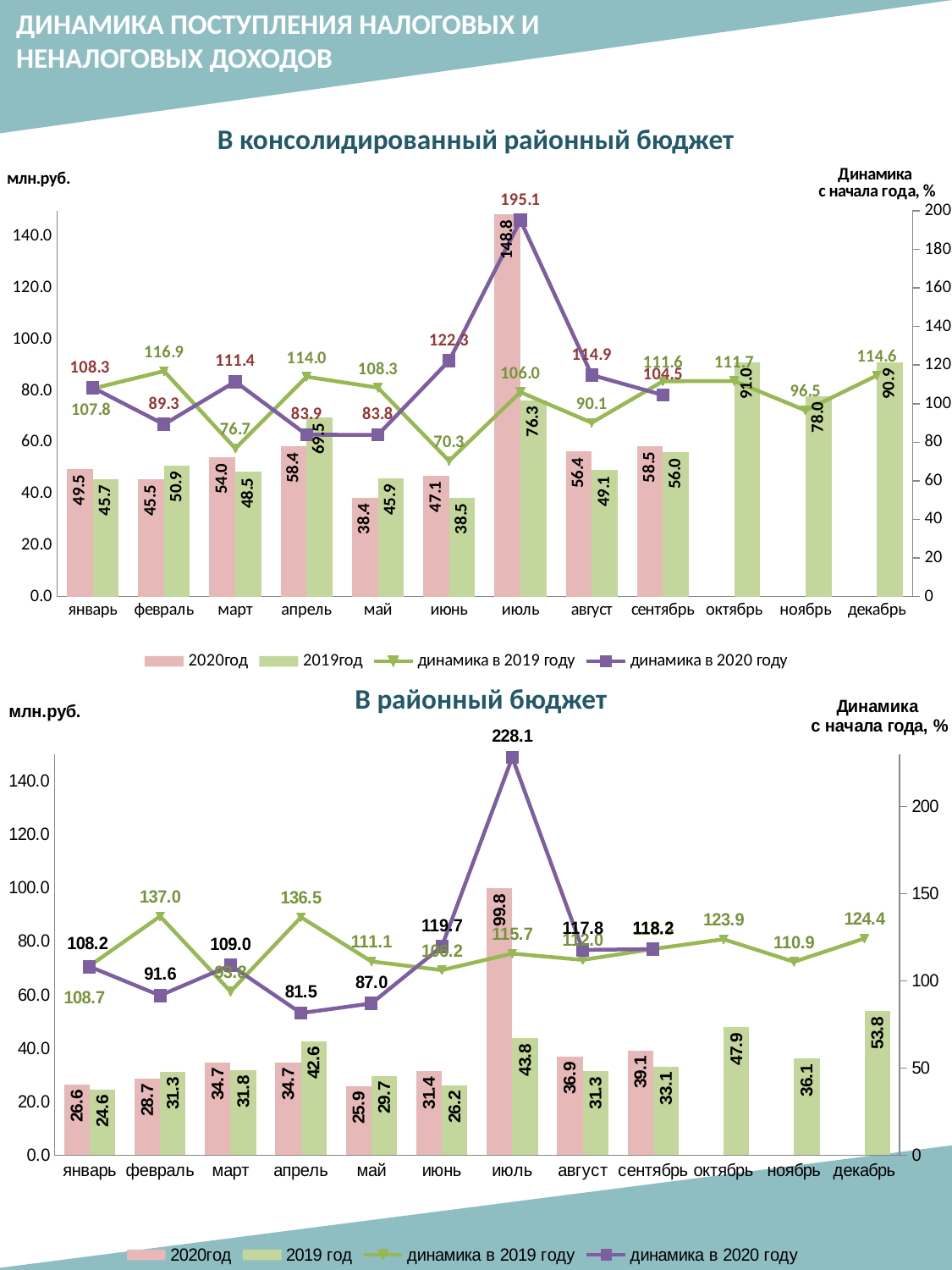
In the chart 'В консолидированный районный бюджет', what is the value of 'динамика в 2020 году' for июль? 195.1 In the chart 'В консолидированный районный бюджет', what is the value of the 2020год bar for июль? 148.8 In the chart 'В консолидированный районный бюджет', which month has the highest 2020год bar? июль In the chart 'В районный бюджет', how many months are shown on the x axis? 12 In the chart 'В консолидированный районный бюджет', which month has the lowest 2019год bar? июнь In the chart 'В районный бюджет', what is the value of 'динамика в 2020 году' for июль? 228.1 In the chart 'В районный бюджет', which is larger for май: the 2020год bar or the 2019год bar? 2019год In the chart 'В районный бюджет', what is the difference between the 2019год bars for декабрь and ноябрь? 17.7 In the chart 'В консолидированный районный бюджет', what is the difference between the 2020год and 2019год bars for апрель? 11.1 In the chart 'В консолидированный районный бюджет', what is the value of the 2019год bar for октябрь? 91.0 In the chart 'В районный бюджет', what is the value of the 2020год bar for июль? 99.8 In the chart 'В консолидированный районный бюджет', how many series does the legend list? 4